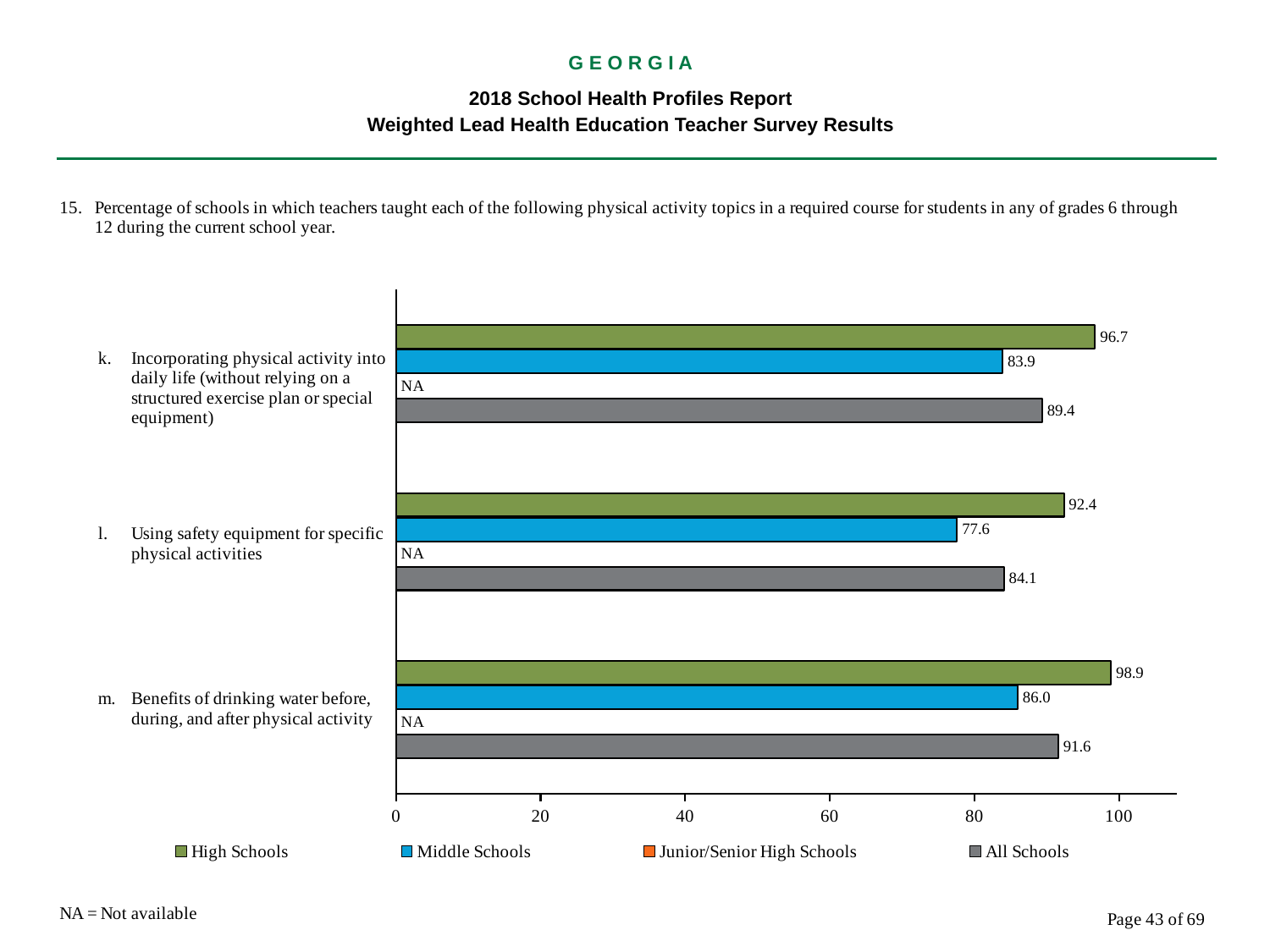
What is the All Schools value for incorporating physical activity into daily life? 89.4 How many physical activity topics are shown on the chart? 3 What percentage of high schools taught the benefits of drinking water before, during, and after physical activity? 98.9 What colour represents High Schools in the legend? Green What is the difference between the High Schools and Middle Schools values for using safety equipment for specific physical activities? 14.8 Which topic has the highest High Schools value? Benefits of drinking water before, during, and after physical activity How many series does the legend list? 4 What kind of chart is shown on the slide? Bar chart Which topic has the lowest Middle Schools value? Using safety equipment for specific physical activities What is the value for Middle Schools for using safety equipment for specific physical activities? 77.6 Which is larger: the All Schools value for incorporating physical activity into daily life or the All Schools value for benefits of drinking water? Benefits of drinking water (91.6) What value is shown for Junior/Senior High Schools for each topic? NA